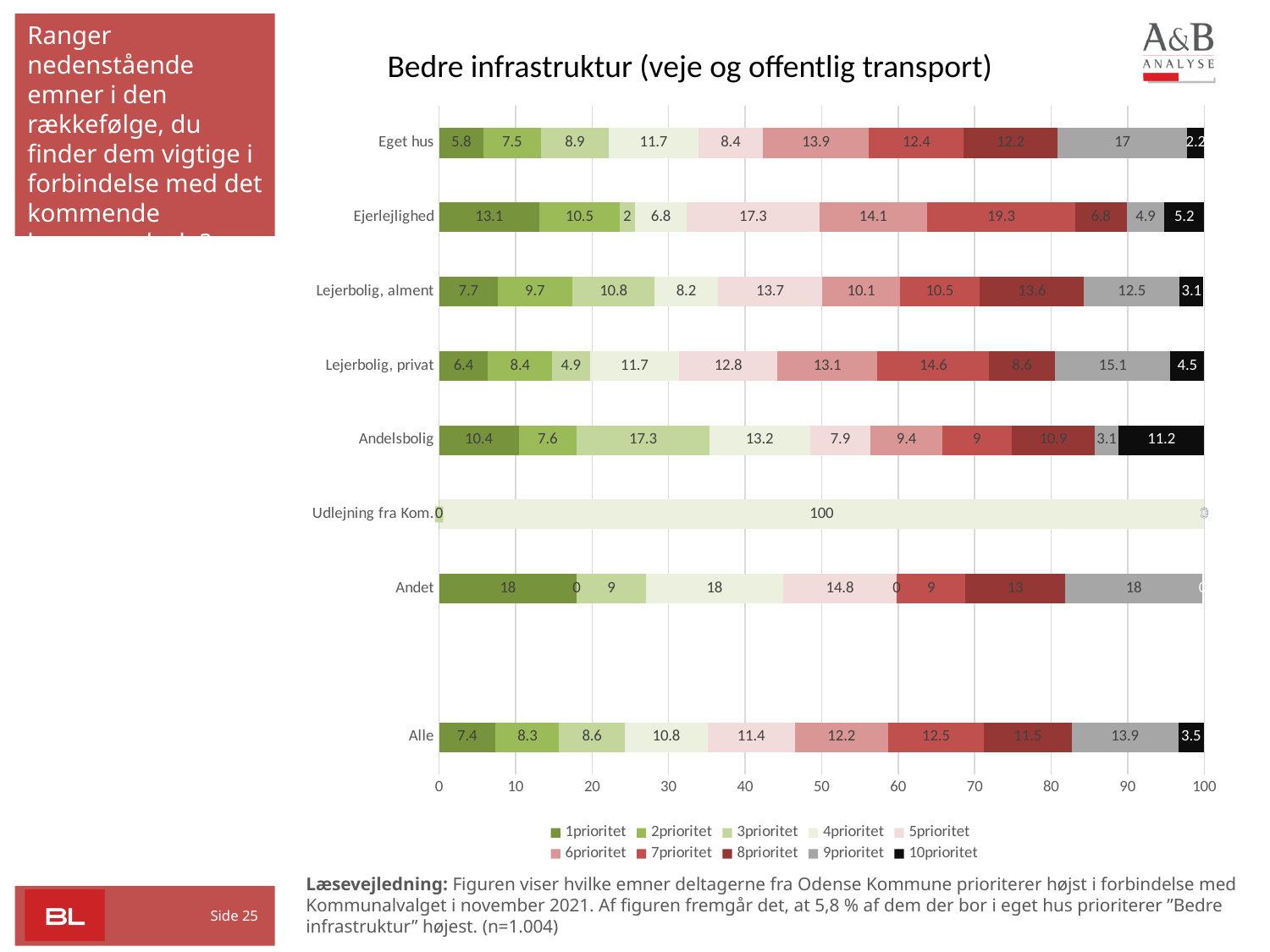
What is the 4prioritet value for Udlejning fra Kom.? 100 How many categories are plotted on the y axis? 8 What is the 10prioritet value for Andelsbolig? 11.2 How many series does the legend list? 10 Which has the larger 7prioritet value, Ejerlejlighed or Eget hus? Ejerlejlighed Which category has the highest 1prioritet value? Andet What is the title of the chart? Bedre infrastruktur (veje og offentlig transport) For Alle, what is the difference between the 9prioritet value and the 10prioritet value? 10.4 What is the 1prioritet value for Eget hus? 5.8 What is the 9prioritet value for Eget hus? 17 What is the 7prioritet value for Lejerbolig, privat? 14.6 What kind of chart is shown on the slide? bar chart